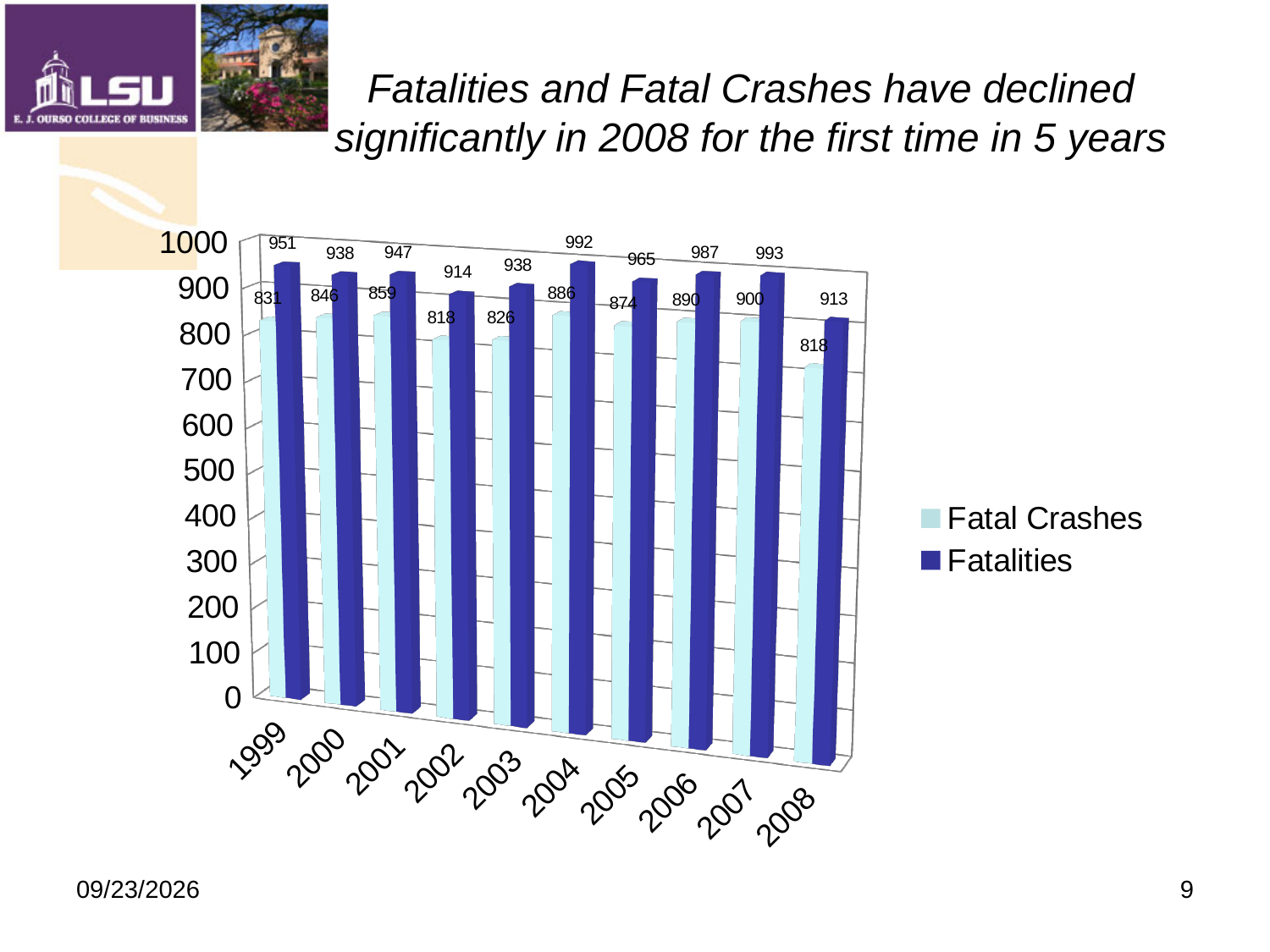
What is the difference between Fatal Crashes in 2006 and Fatal Crashes in 2005? 16 Which year had the highest number of Fatal Crashes? 2007 Which year had more Fatalities, 2004 or 2005? 2004 What is the number of Fatal Crashes in 2001? 859 What is the number of Fatal Crashes in 2004? 886 What kind of chart is shown on the slide? bar chart What is the difference between Fatalities and Fatal Crashes in 2007? 93 What is the number of Fatalities in 2008? 913 Is the value for Fatal Crashes in 2002 greater or less than 900? less How many years are shown on the x axis? 10 What is the number of Fatalities in 1999? 951 How many series does the legend list? 2